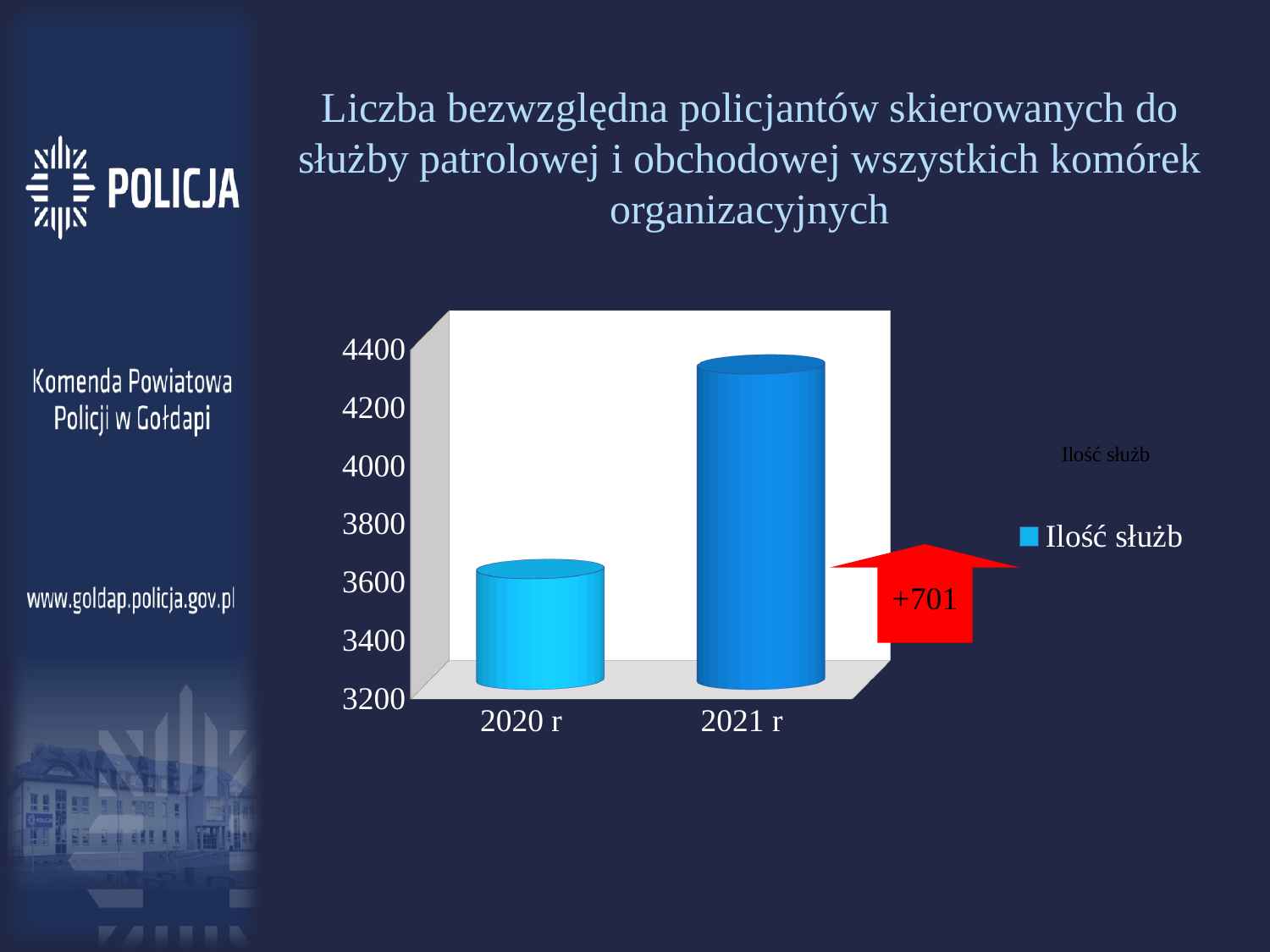
Which year has the higher value in the chart? 2021 r How many series does the chart legend list? 1 Is the value for 2020 r greater or less than 3400? greater Which year has the lower value in the chart? 2020 r What increase does the red arrow next to the chart indicate? +701 What kind of chart is shown on the slide? bar chart Is the value for 2020 r greater or less than 3800? less Do the values rise or fall from 2020 r to 2021 r? rise Is the value for 2021 r greater or less than 4000? greater What is the name of the series listed in the chart legend? Ilość służb Is the value for 2021 r larger or smaller than the value for 2020 r? larger How many categories are shown on the x axis of the chart? 2